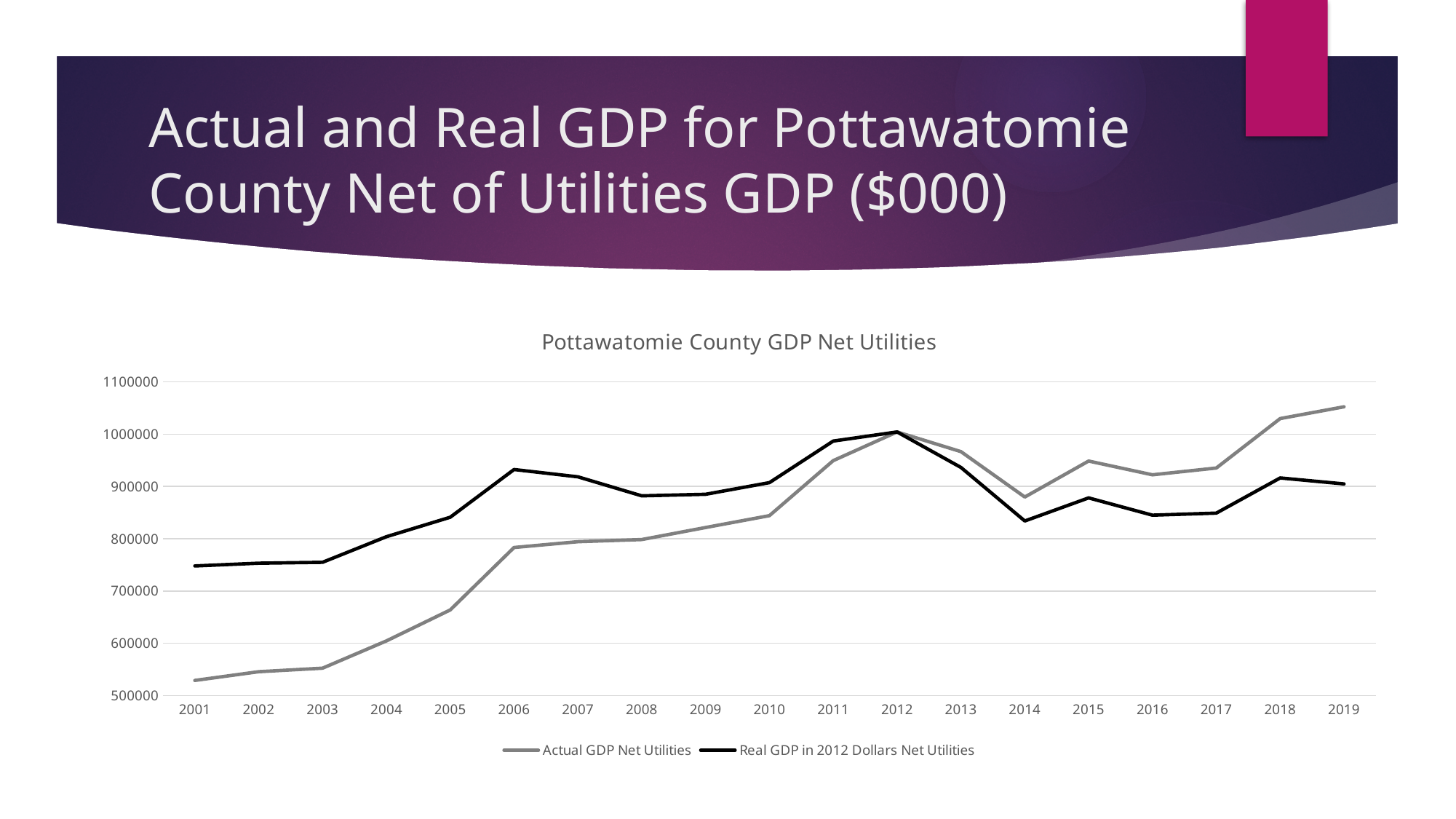
In which year is Actual GDP Net Utilities highest? 2019 What kind of chart is shown on the slide? line chart Is the value for Actual GDP Net Utilities in 2001 greater or less than 600000? less How many series does the legend list? 2 In 2001, which is larger: Actual GDP Net Utilities or Real GDP in 2012 Dollars Net Utilities? Real GDP in 2012 Dollars Net Utilities In which year is Actual GDP Net Utilities lowest? 2001 Does Actual GDP Net Utilities rise or fall from 2001 to 2006? rise How many years are plotted along the x axis? 19 Is the value for Actual GDP Net Utilities in 2019 greater or less than 1000000? greater What is the title of the chart? Pottawatomie County GDP Net Utilities Which series is drawn in black? Real GDP in 2012 Dollars Net Utilities In which year is Real GDP in 2012 Dollars Net Utilities highest? 2012